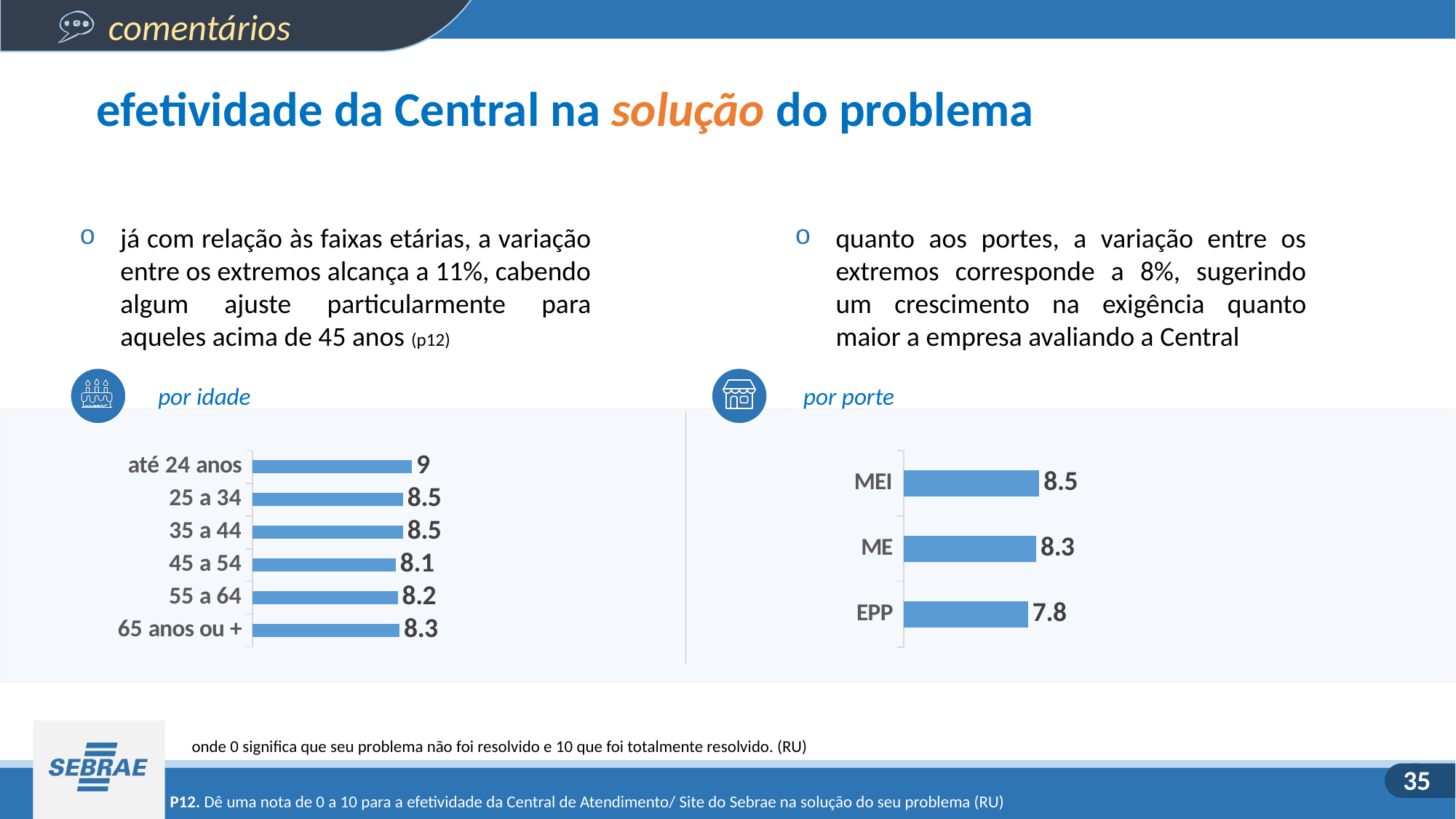
In the 'por idade' chart, which age group has the lowest value? 45 a 54 In the 'por idade' chart, which age group has the highest value? até 24 anos What kind of chart is the 'por porte' chart? bar chart In the 'por porte' chart, what is the value for 'ME'? 8.3 In the 'por idade' chart, what is the value for 'até 24 anos'? 9 In the 'por porte' chart, which is larger: the value for 'MEI' or the value for 'ME'? MEI In the 'por porte' chart, what is the difference between the values for 'MEI' and 'EPP'? 0.7 In the 'por porte' chart, what is the value for 'EPP'? 7.8 In the 'por idade' chart, how many age groups are shown? 6 In the 'por idade' chart, what is the value for '45 a 54'? 8.1 In the 'por porte' chart, which category has the lowest value? EPP In the 'por idade' chart, what is the difference between the values for 'até 24 anos' and '45 a 54'? 0.9